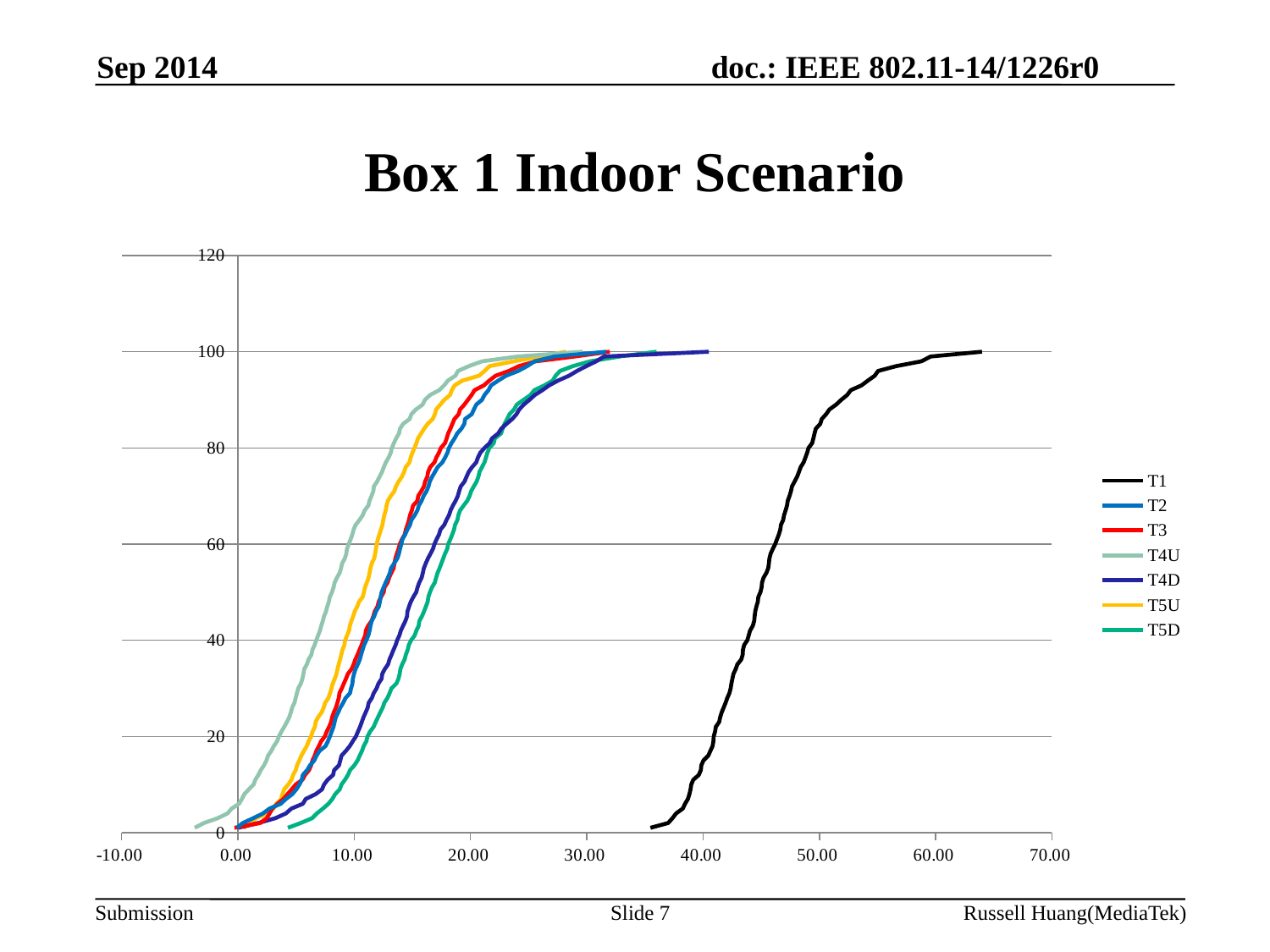
Which series is drawn in black? T1 Do the values of the T1 series rise or fall as x increases? rise Which series lies furthest to the right on the chart? T1 What is the title of the chart? Box 1 Indoor Scenario Is the value of the T4U series at x = 10.00 greater or less than 40? greater Is the value of the T1 series at x = 60.00 greater or less than 80? greater Is the value of the T1 series at x = 40.00 greater or less than 20? less What is the highest value shown on the y axis? 120 What kind of chart is shown on the slide? line chart How many series does the legend list? 7 Which series lies furthest to the left on the chart? T4U